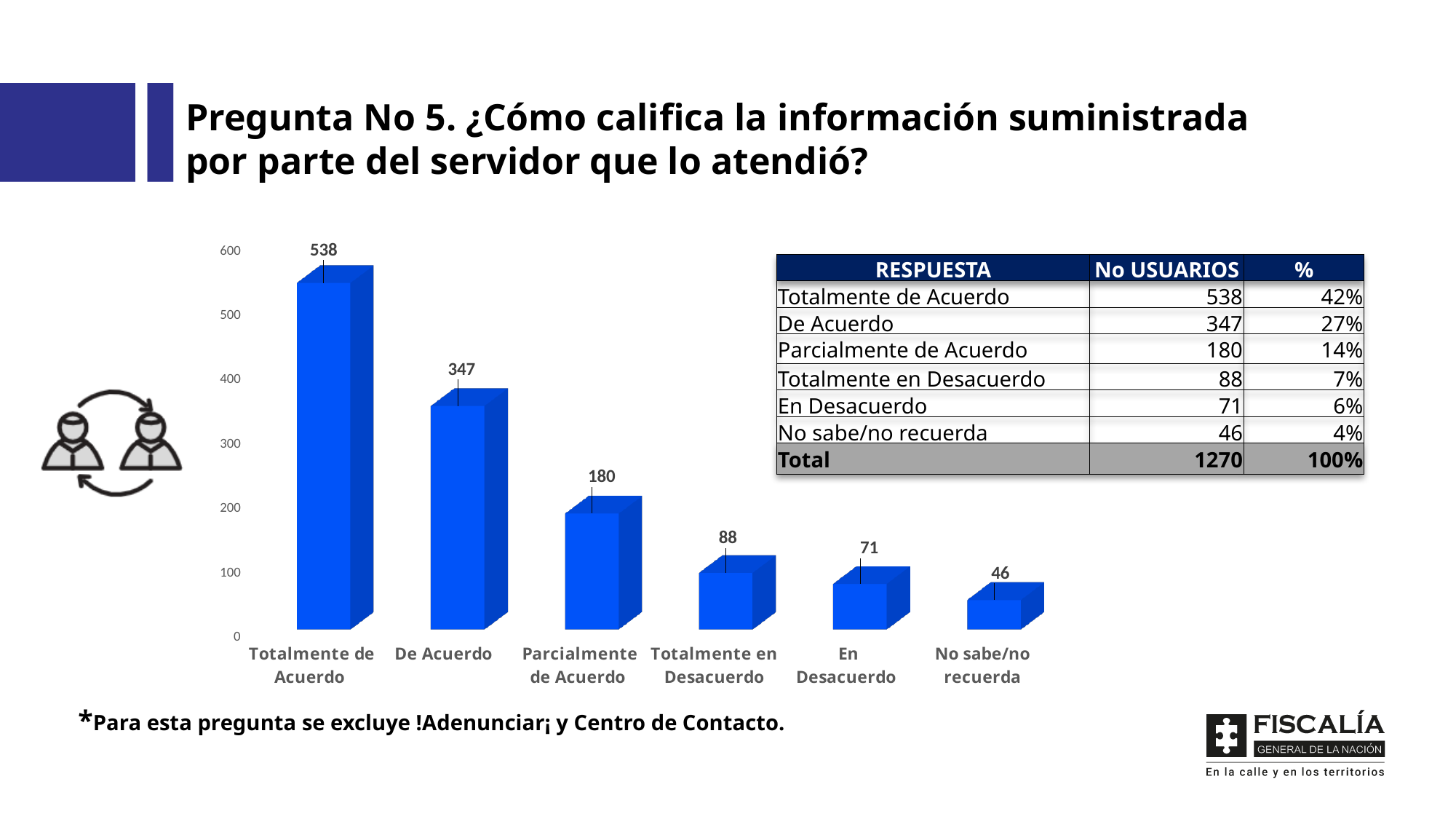
Which category has the lowest value in the bar chart? No sabe/no recuerda What is the value for "No sabe/no recuerda" in the bar chart? 46 Do the values rise or fall from left to right along the x axis of the bar chart? fall Which is larger, the value for "Parcialmente de Acuerdo" or the value for "Totalmente en Desacuerdo"? Parcialmente de Acuerdo What is the difference between the values for "Totalmente en Desacuerdo" and "En Desacuerdo"? 17 How many categories are shown in the bar chart? 6 What is the value for "Parcialmente de Acuerdo" in the bar chart? 180 What kind of chart is shown on the slide? bar chart Is the value for "De Acuerdo" greater or less than 300? greater Which category has the highest value in the bar chart? Totalmente de Acuerdo What is the value for "De Acuerdo" in the bar chart? 347 What is the difference between the values for "Totalmente de Acuerdo" and "De Acuerdo"? 191